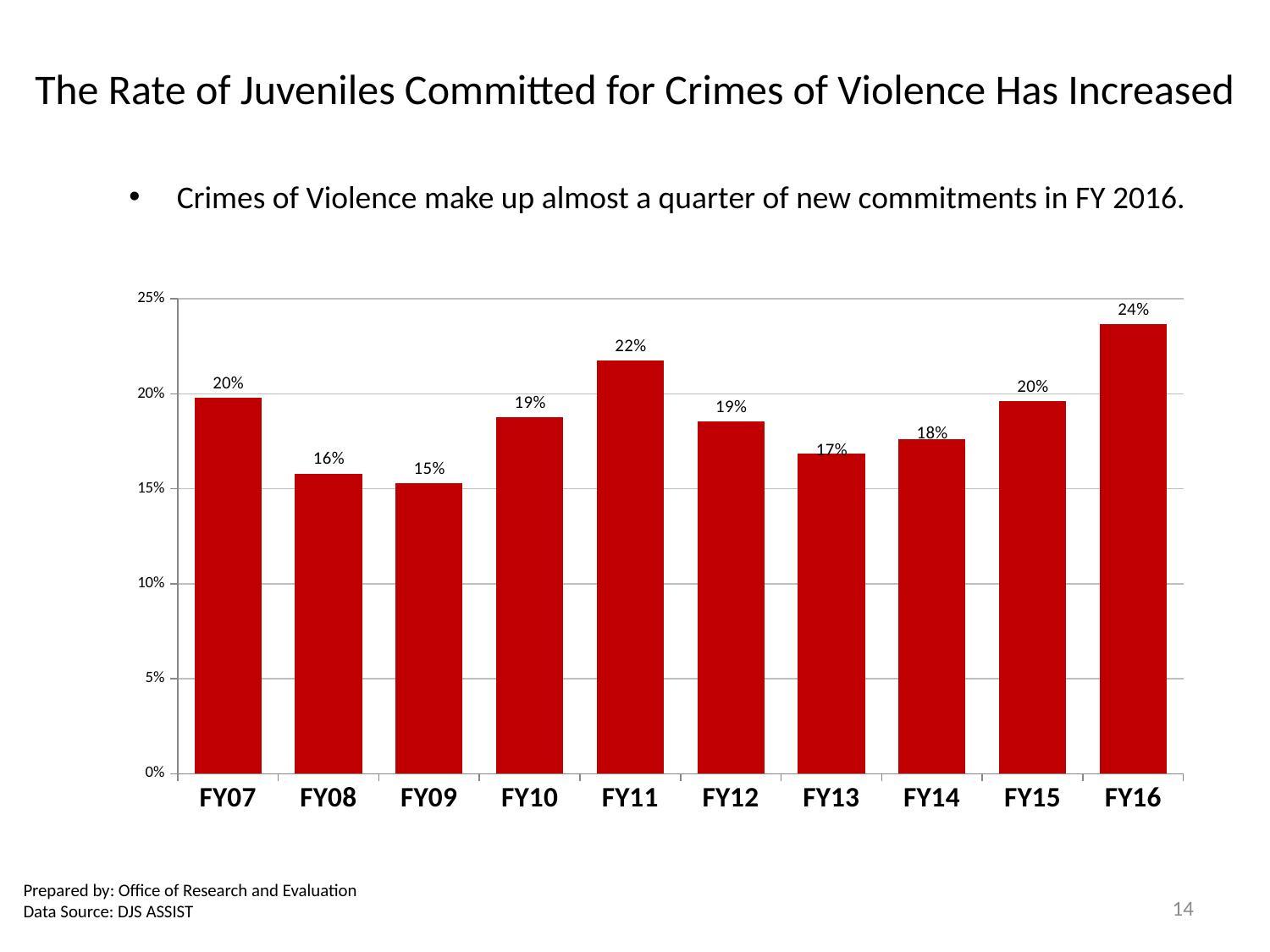
Is the value for FY13 greater or less than 15%? greater Which fiscal year has the highest value? FY16 Which fiscal year has the lowest value? FY09 How many fiscal years are shown on the x axis? 10 What colour are the bars in the chart? red Do the values rise or fall from FY13 to FY16? rise What is the difference between the values for FY16 and FY09? 9% What is the value for FY11? 22% What is the value for FY09? 15% Which is larger, the value for FY11 or the value for FY12? FY11 What is the value for FY16? 24% What kind of chart is shown on the slide? bar chart